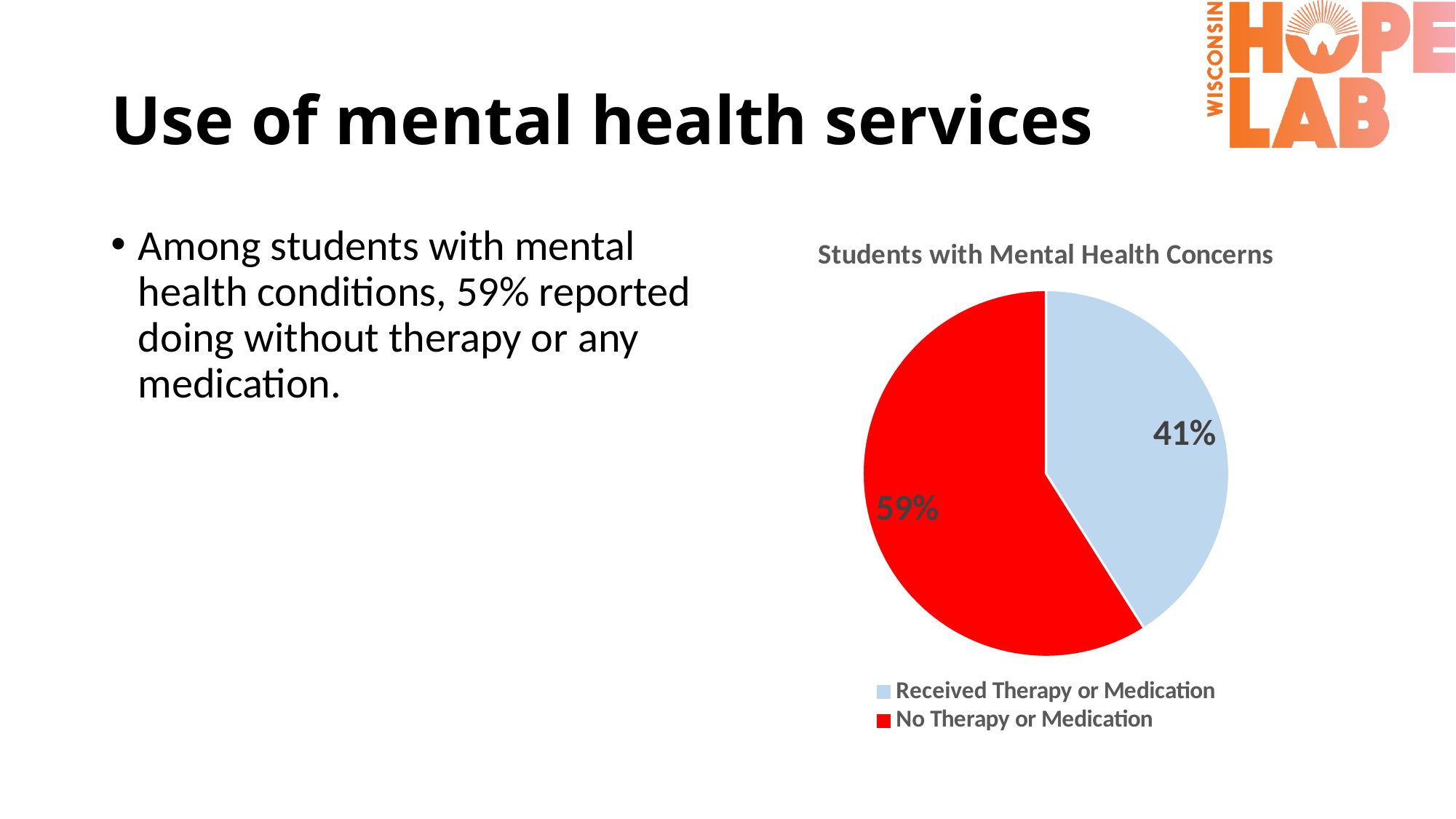
What colour is the No Therapy or Medication slice? red Which is larger: the share that received therapy or medication, or the share with no therapy or medication? No Therapy or Medication Which slice of the pie is the largest? No Therapy or Medication Which slice of the pie is the smallest? Received Therapy or Medication What share of students with mental health concerns received therapy or medication? 41% What is the difference in percentage points between the No Therapy or Medication slice and the Received Therapy or Medication slice? 18 How many entries does the legend list? 2 What kind of chart is shown on the slide? pie chart Is the share of students who received therapy or medication greater or less than 50%? less What is the title of the chart? Students with Mental Health Concerns How many slices does the pie chart have? 2 What share of students with mental health concerns had no therapy or medication? 59%